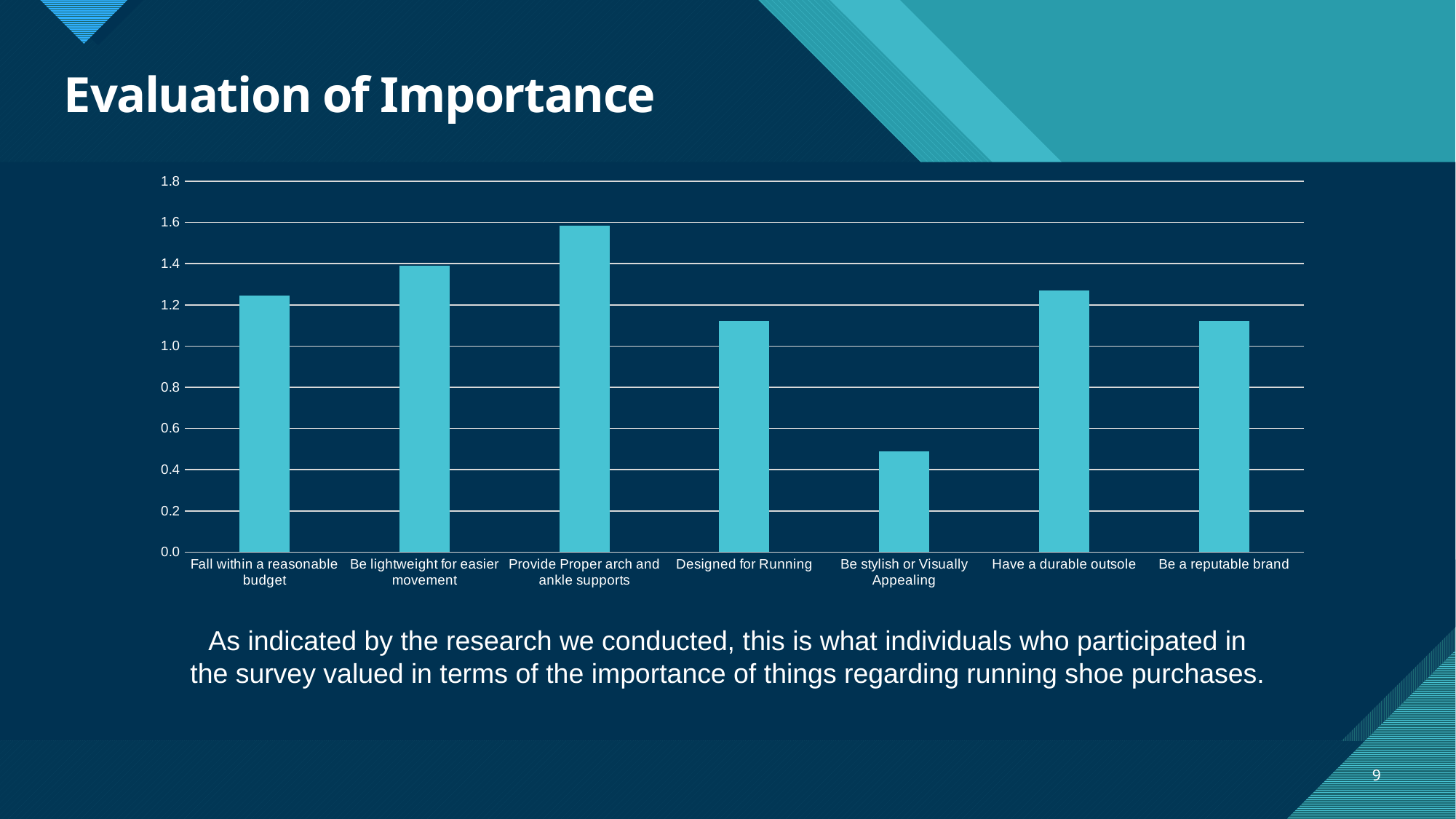
Is the value for Designed for Running greater or less than 1.0? greater What is the title of the slide containing the chart? Evaluation of Importance How many categories are shown on the x axis of the chart? 7 Is the value for Be lightweight for easier movement greater or less than 1.2? greater Is the value for Provide Proper arch and ankle supports greater or less than 1.4? greater Which category has the highest bar in the chart? Provide Proper arch and ankle supports What kind of chart is shown on the slide? bar chart Which is larger, the value for Have a durable outsole or the value for Be stylish or Visually Appealing? Have a durable outsole Which category has the lowest bar in the chart? Be stylish or Visually Appealing Which is larger, the value for Be lightweight for easier movement or the value for Fall within a reasonable budget? Be lightweight for easier movement